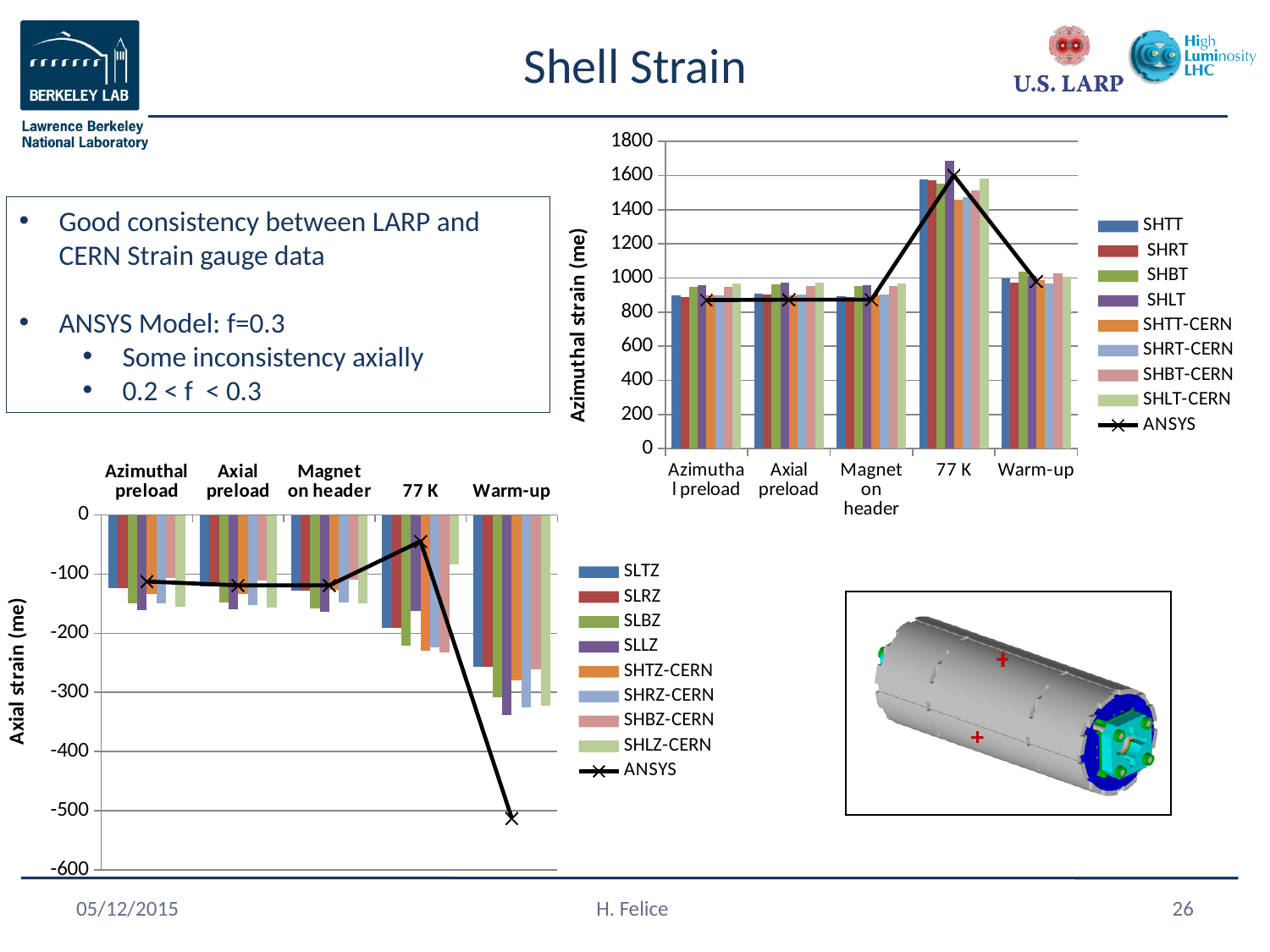
In the top-right chart (Azimuthal strain), is the SHTT value at Azimuthal preload greater or less than 1000? less In the bottom-left chart (Axial strain), which category has the most negative values? Warm-up What kind of chart is the bottom-left chart (Axial strain)? combination bar and line chart In the top-right chart (Azimuthal strain), which is larger for SHTT: the value at 77 K or the value at Warm-up? 77 K In the top-right chart (Azimuthal strain), which category has the highest values? 77 K How many series does the legend of the bottom-left chart (Axial strain) list? 9 In the top-right chart (Azimuthal strain), is the SHLT value at 77 K greater or less than 1600? greater In the bottom-left chart (Axial strain), is the ANSYS value at Warm-up greater or less than -500? less How many categories are shown on the x axis of the top-right chart (Azimuthal strain)? 5 What is the y-axis title of the top-right chart? Azimuthal strain (me) How many series does the legend of the top-right chart (Azimuthal strain) list? 9